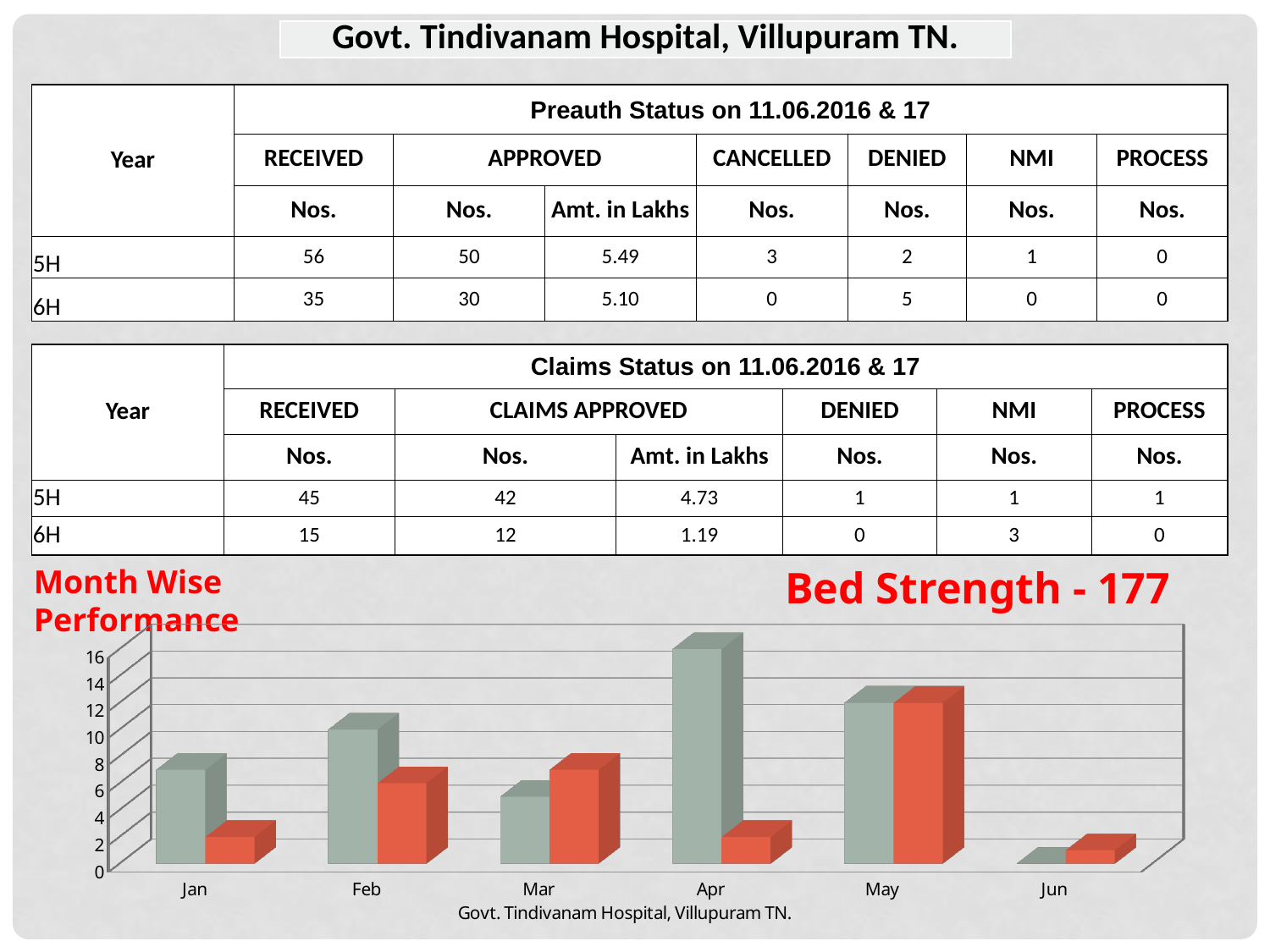
Is the red bar for Jan greater or less than 4? less What is the highest value shown on the vertical axis of the bar chart? 16 In the bar chart, which month has the shortest grey bar? Jun In the bar chart, which month has the tallest red bar? May Is the grey bar for Jun greater or less than 4? less How many months are shown on the x axis of the bar chart? 6 What kind of chart is shown at the bottom of the slide? bar chart For Feb, which bar is taller, the grey bar or the red bar? grey bar In the bar chart, which month has the tallest grey bar? Apr For Mar, which bar is taller, the grey bar or the red bar? red bar Is the grey bar for Apr greater or less than 14? greater